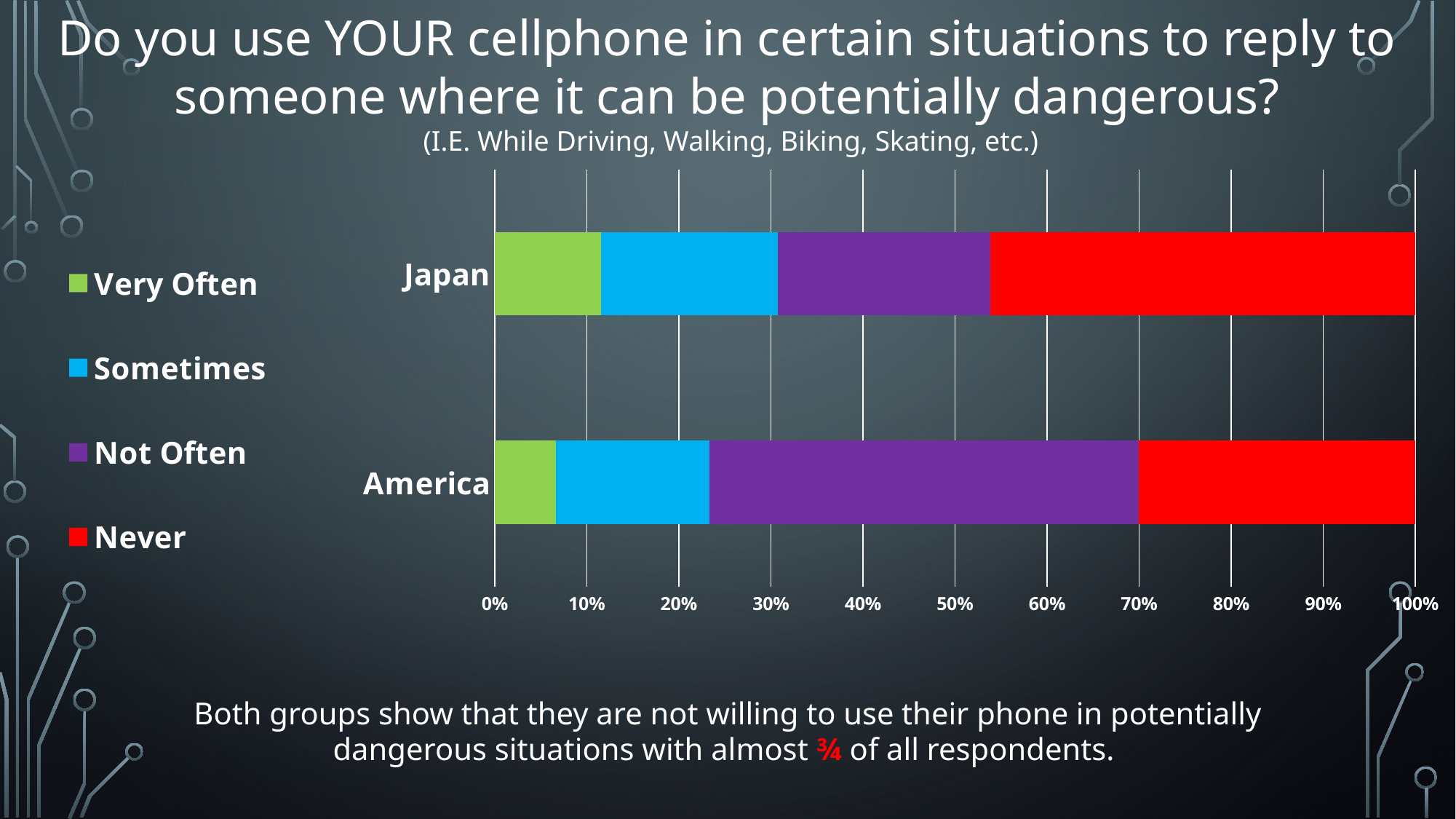
Which response category takes up the largest share of the America bar? Not Often Which country has the larger 'Not Often' share, Japan or America? America Is the 'Never' share for Japan greater or less than 40%? greater Which response category takes up the largest share of the Japan bar? Never What kind of chart is shown on the slide? Stacked bar chart Which colour represents 'Never' in the legend? Red Which country has the larger 'Never' share, Japan or America? Japan How many categories (countries) are plotted on the chart? 2 How many series does the legend list? 4 Is the 'Very Often' share for America greater or less than 10%? less Which colour represents 'Sometimes' in the legend? Blue Which country has the larger 'Very Often' share, Japan or America? Japan